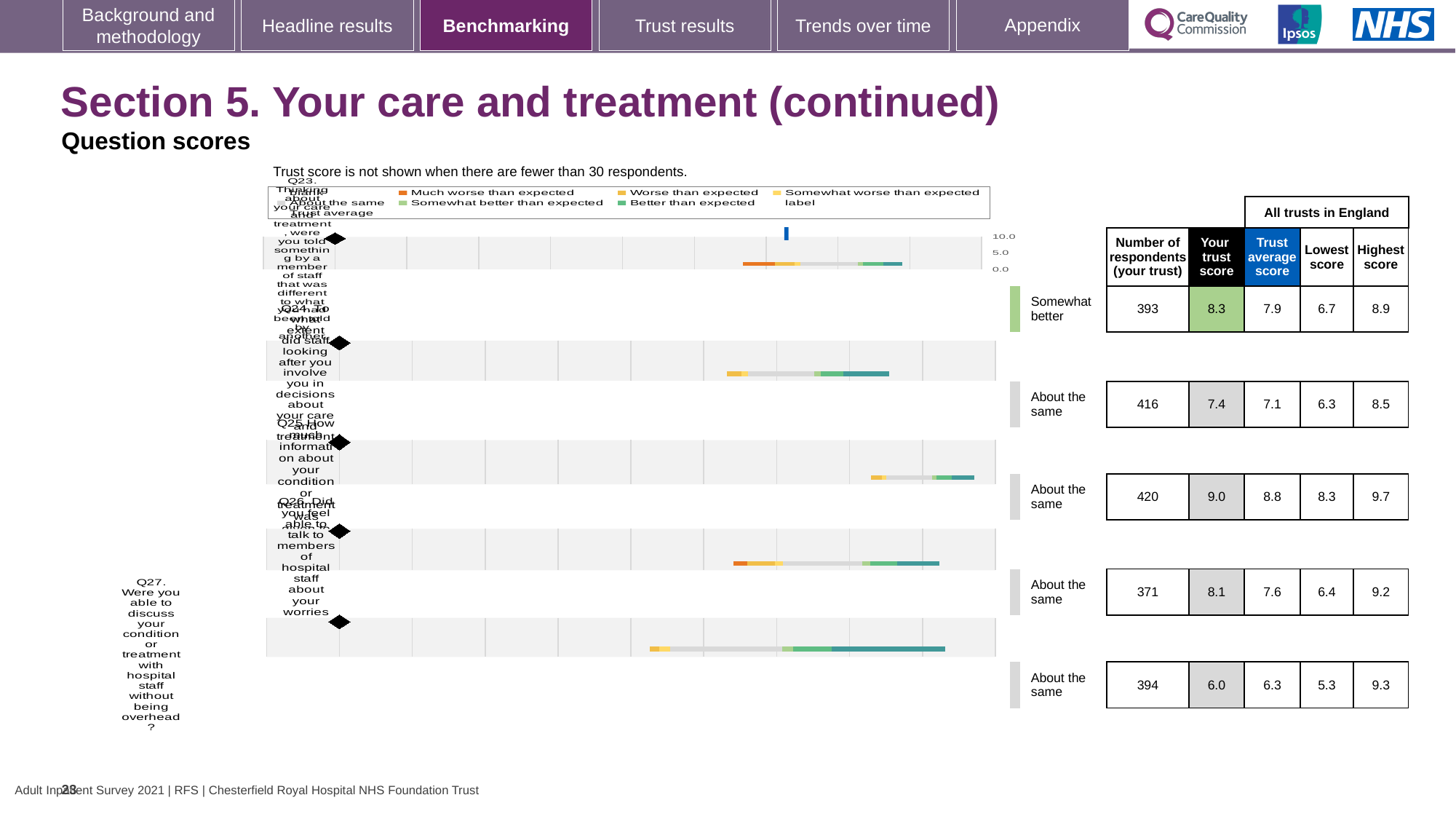
Which question has the highest trust score on this slide? Q25 Which question has the lowest trust score on this slide? Q27 How many respondents answered Q25 at this trust? 420 Which is larger for Q27: the trust score or the trust average score? Trust average score What is the difference between the trust score and the trust average score for Q24? 0.3 What is the trust average score for Q23? 7.9 What is the trust score for Q27 (discussing your condition or treatment without being overheard)? 6.0 How many questions are shown on this slide? 5 What is the lowest score across all trusts in England for Q27? 5.3 Which question is rated 'Somewhat better' than expected? Q23 What kind of chart is used to show the question scores? Bar chart What is the highest score across all trusts in England for Q26? 9.2